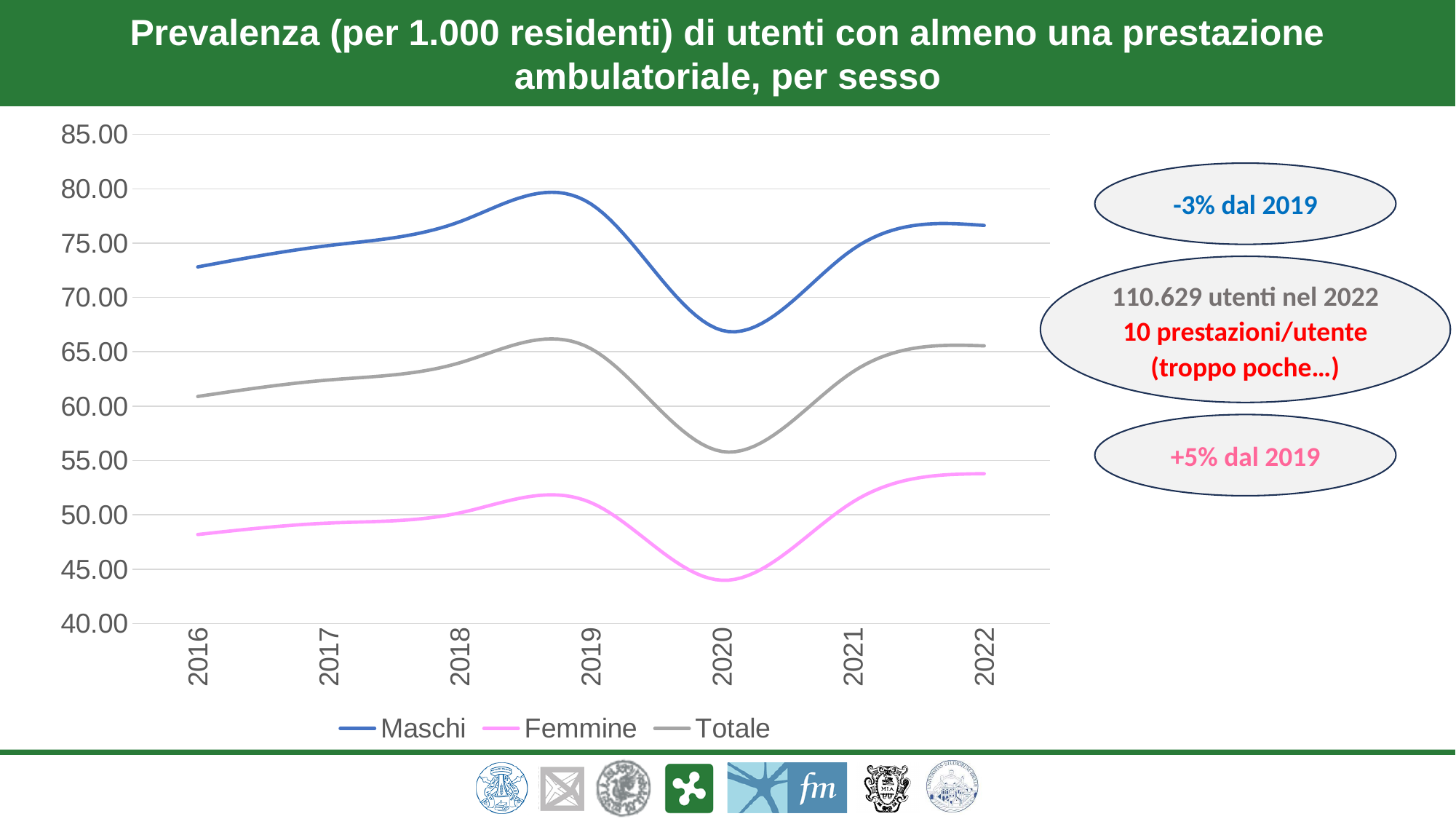
How many years are shown on the x axis? 7 In which year does the Femmine series reach its lowest value? 2020 Is the value for Maschi in 2020 greater or less than 70.00? less In which year does the Maschi series reach its highest value? 2019 Which series has the higher value in 2020, Maschi or Femmine? Maschi In which year does the Totale series reach its lowest value? 2020 Does the Maschi series rise or fall between 2019 and 2020? Fall Which colour is used for the Femmine series? Pink Is the value for Totale in 2020 greater or less than 60.00? less What kind of chart is shown on the slide? Line chart How many series does the legend list? 3 Is the value for Femmine in 2022 greater or less than 50.00? greater